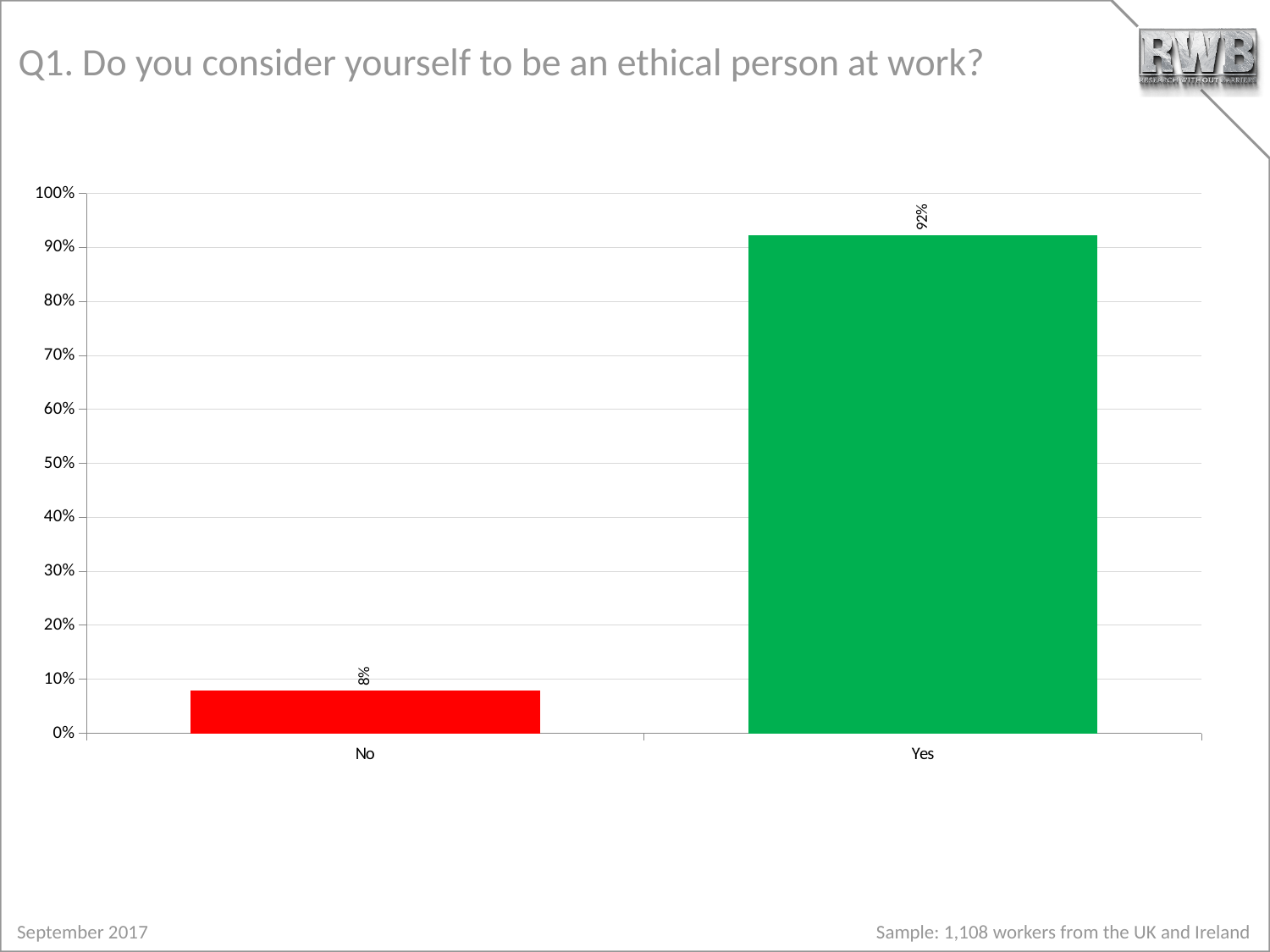
Which category has the highest value? Yes What is the difference between the "Yes" and "No" percentages? 84% What colour is the bar for "Yes"? Green What kind of chart is shown on the slide? Bar chart What percentage of respondents answered "Yes"? 92% What is the question shown as the slide title? Q1. Do you consider yourself to be an ethical person at work? What percentage of respondents answered "No"? 8% Is the value for "No" greater or less than 10%? less How many categories are shown on the x axis? 2 Which category has the lowest value? No Which is larger, the value for "Yes" or the value for "No"? Yes Is the value for "Yes" greater or less than 90%? greater